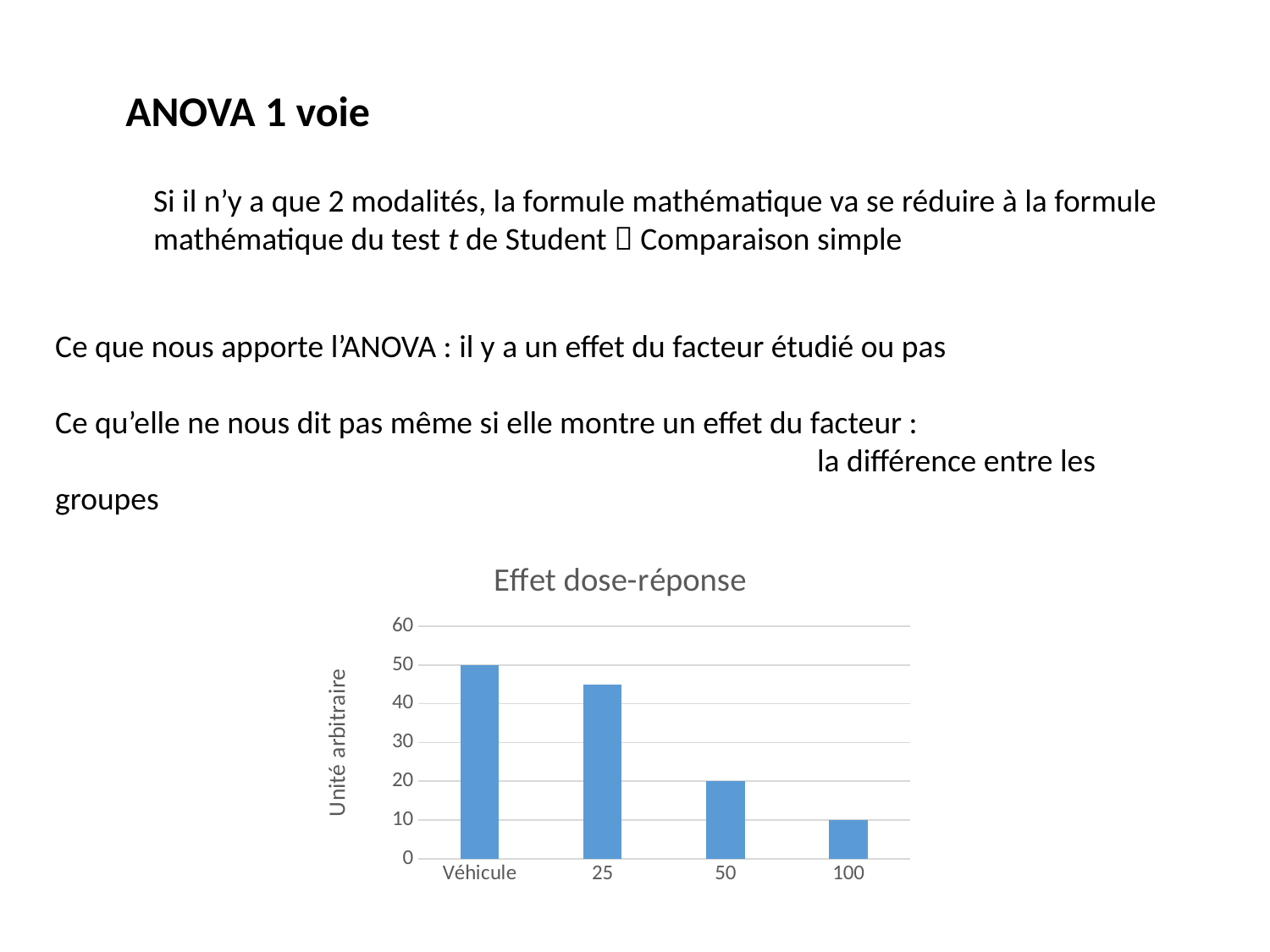
What type of chart is shown on the slide? bar chart What is the value for the 50 category? 20 Which category has the highest value? Véhicule Which category has the lowest value? 100 Do the values rise or fall from left to right along the x axis? fall How many categories are shown on the x axis of the chart? 4 Is the value for the 25 category greater or less than 50? less What is the title of the chart? Effet dose-réponse What is the value for Véhicule? 50 What is the value for the 100 category? 10 Is the value for the 25 category greater or less than 40? greater What is the y-axis label of the chart? Unité arbitraire